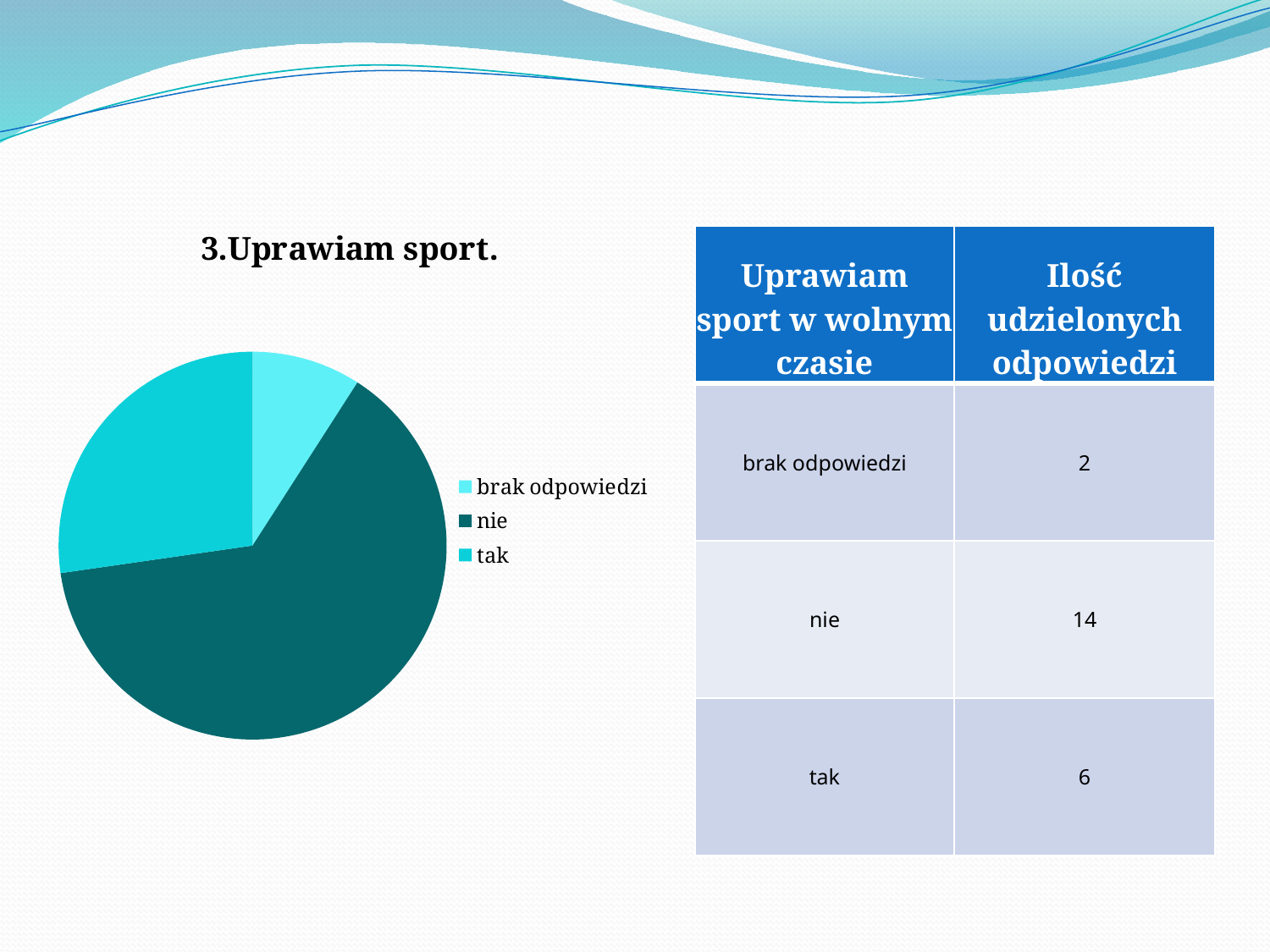
What is the total number of responses across all three categories? 22 What kind of chart is shown on the slide? pie chart Is the slice for 'tak' larger or smaller than the slice for 'nie'? smaller How many slices does the pie chart have? 3 According to the table, how many responses were 'nie'? 14 How many entries does the chart legend list? 3 According to the table, how many responses were 'tak'? 6 Which category has the largest slice of the pie? nie Which category has the smallest slice of the pie? brak odpowiedzi What is the title of the chart? 3.Uprawiam sport. According to the table, how many responses were 'brak odpowiedzi'? 2 What is the difference between the number of 'nie' responses and 'tak' responses? 8